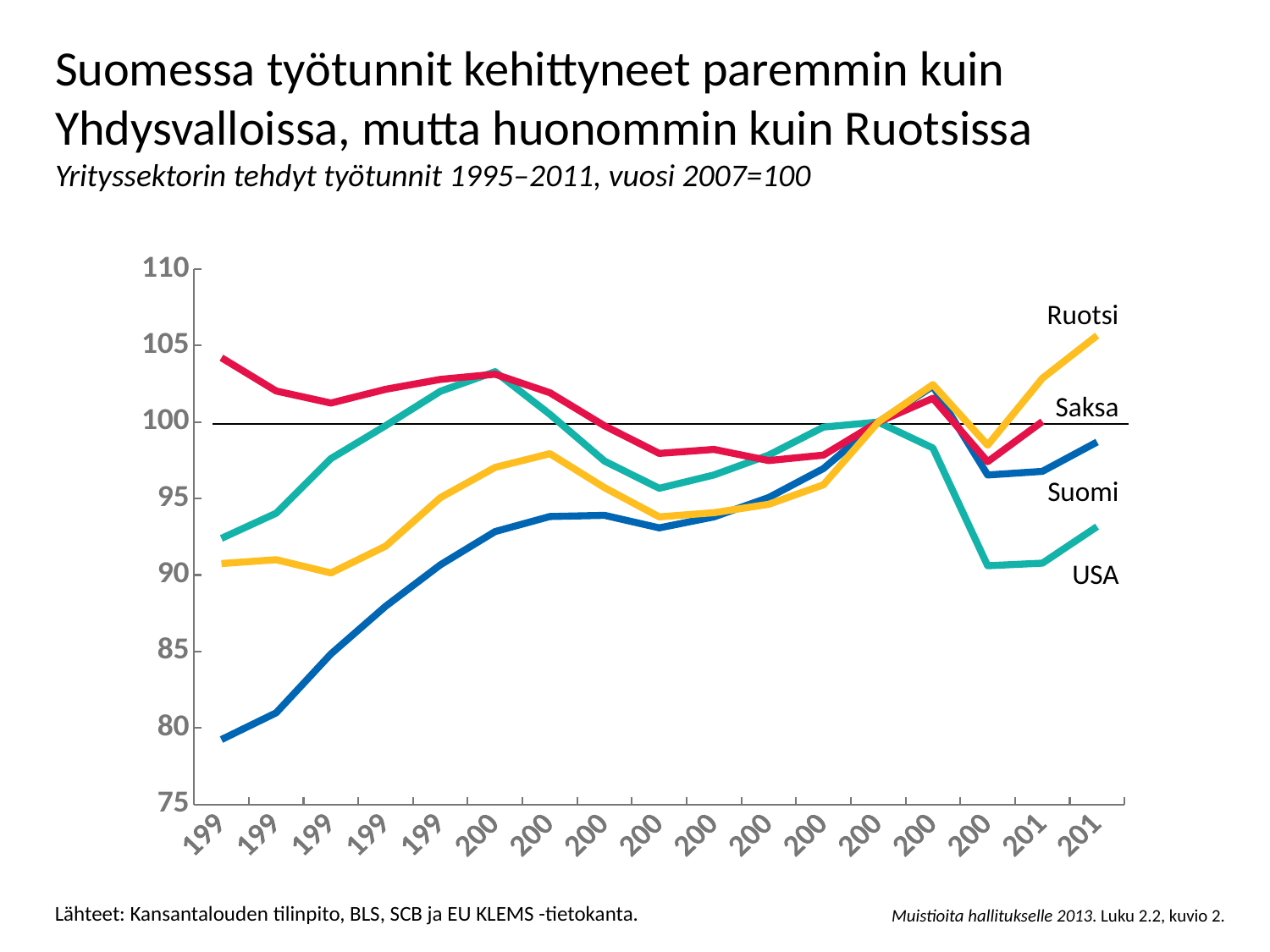
Which series has the lowest value at the start of the chart (1995)? Suomi Does the Suomi line rise or fall overall from 1995 to 2011? rises How many series are labelled on the chart? 4 In 1995, which series has the higher value, Saksa or USA? Saksa Is the value for USA in 2011 greater or less than 95? less What kind of chart is shown on the slide? line chart Is the value for Ruotsi in 1995 greater or less than 95? less Which series has the lowest value at the right end of the chart (2011)? USA Is the value for Ruotsi in 2011 greater or less than 100? greater Which series has the highest value at the right end of the chart (2011)? Ruotsi At what value is the horizontal reference line drawn across the chart? 100